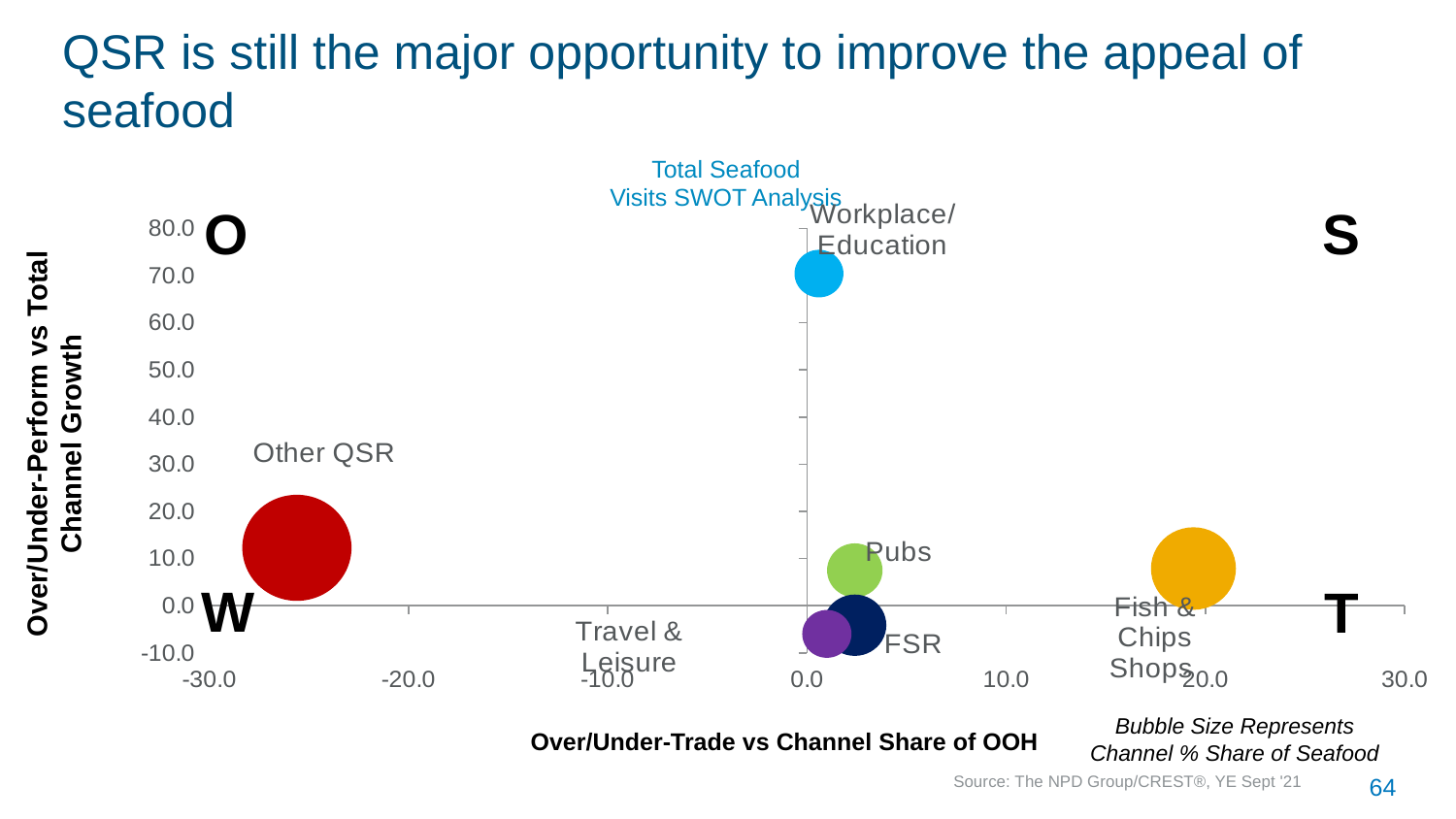
Is the Over/Under-Perform vs Total Channel Growth value for Travel & Leisure greater or less than 0.0? less Is the Over/Under-Perform vs Total Channel Growth value for Workplace/Education greater or less than 60.0? greater Is the Over/Under-Trade vs Channel Share of OOH value for Fish & Chips Shops greater or less than 10.0? greater Which channel is plotted furthest to the left on the Over/Under-Trade vs Channel Share of OOH axis? Other QSR Which channel is plotted furthest to the right on the Over/Under-Trade vs Channel Share of OOH axis? Fish & Chips Shops Which has the higher Over/Under-Perform vs Total Channel Growth value, Workplace/Education or Pubs? Workplace/Education Which channel has the highest Over/Under-Perform vs Total Channel Growth value? Workplace/Education How many channel bubbles are plotted on the chart? 6 What is the title of the chart? Total Seafood Visits SWOT Analysis What kind of chart is shown on the slide? Bubble chart Which channel has the largest bubble on the chart? Other QSR